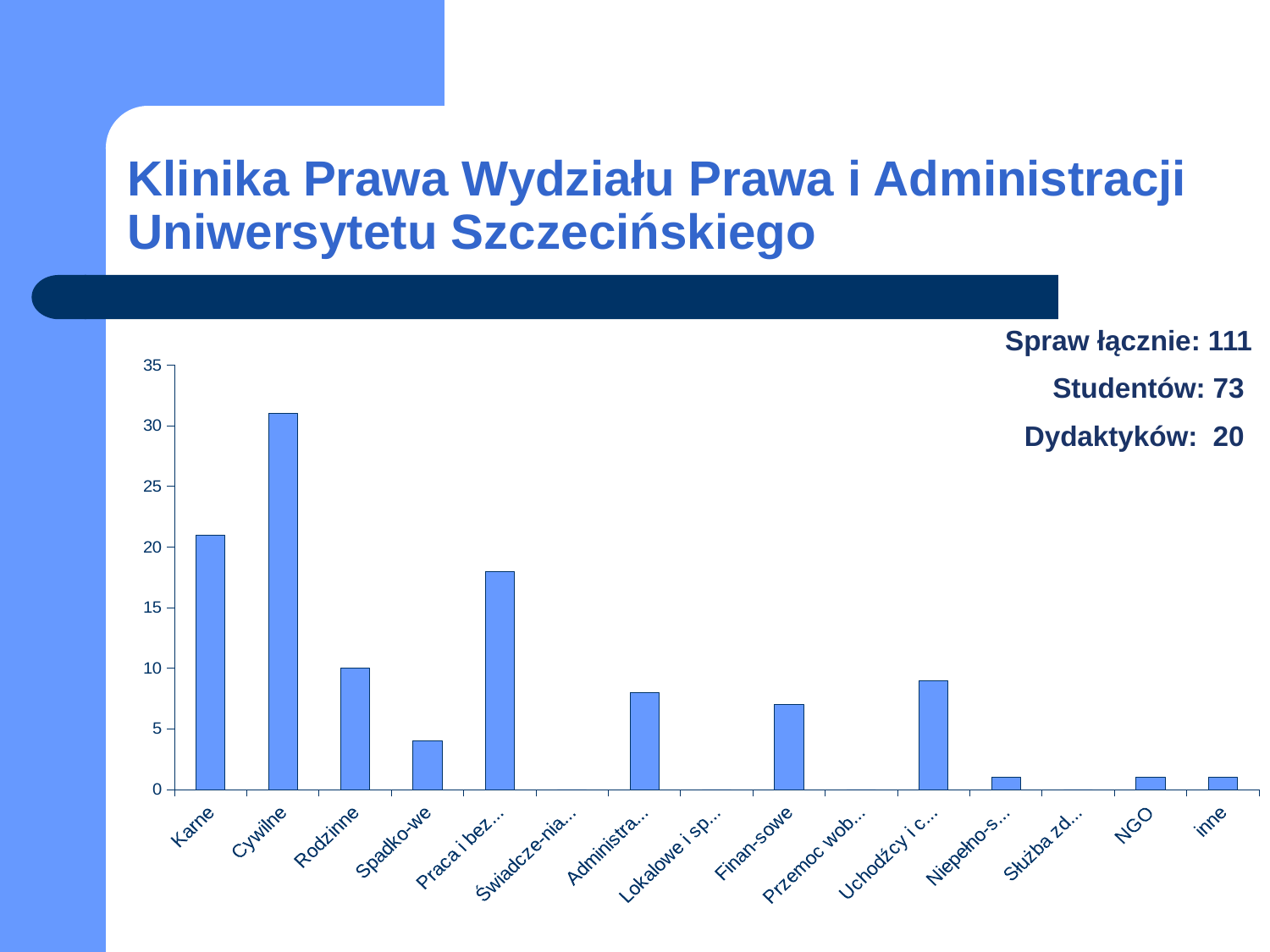
Which is larger, the value for Karne or the value for Cywilne? Cywilne What kind of chart is shown on the slide? bar chart How many categories are shown on the x axis of the chart? 15 Is the value for Spadko-we greater or less than 5? less Is the value for Karne greater or less than 20? greater What is the highest value shown on the y axis of the chart? 35 What is the value for Rodzinne in the chart? 10 Which category has the highest bar in the chart? Cywilne Is the value for Uchodźcy i c... greater or less than 5? greater Which is larger, the value for Rodzinne or the value for Spadko-we? Rodzinne